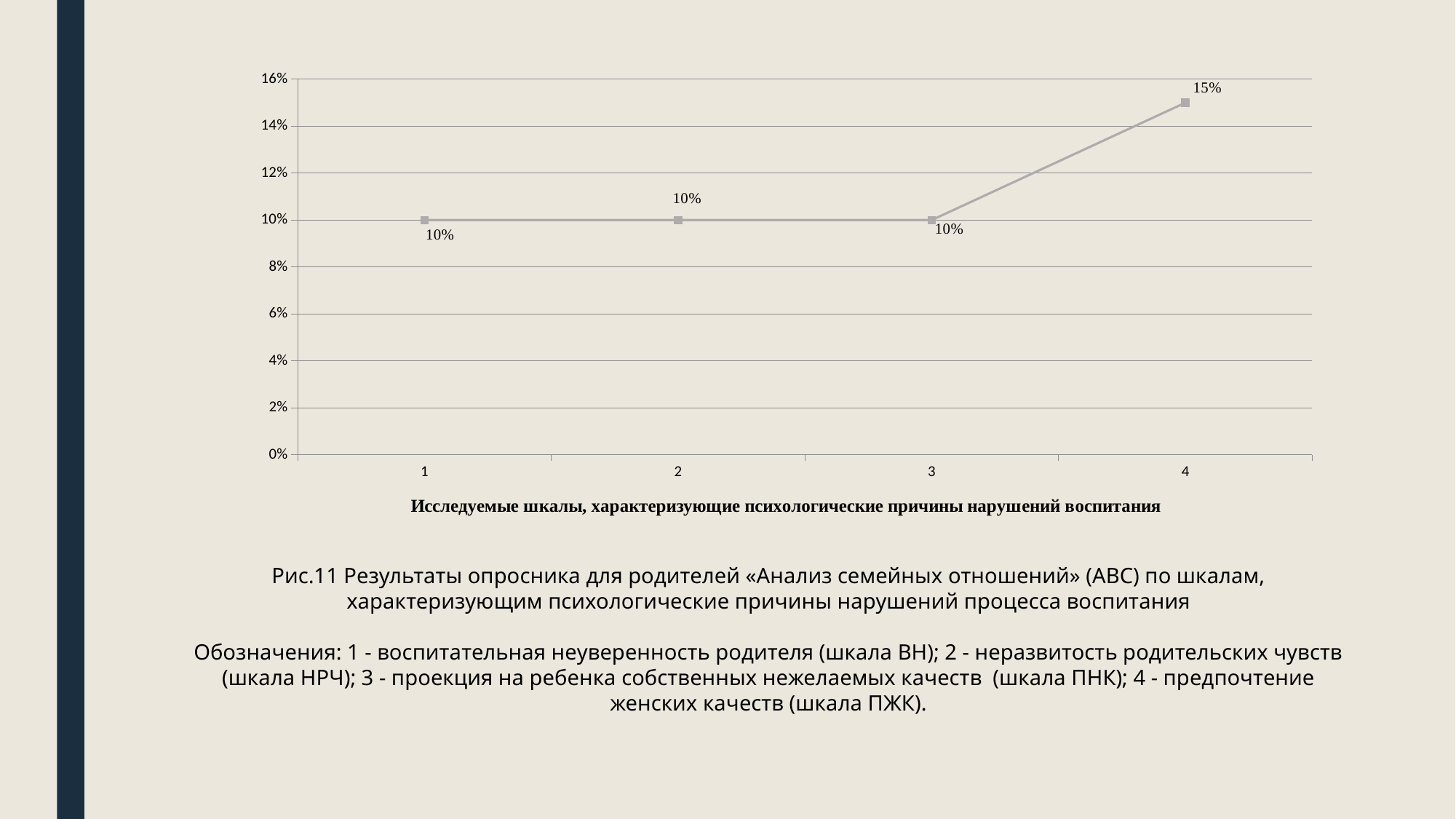
What is the x-axis title of the chart? Исследуемые шкалы, характеризующие психологические причины нарушений воспитания What is the difference between the values for category 4 and category 3? 5% What kind of chart is shown on the slide? line chart Which is larger, the value for category 4 or the value for category 1? category 4 Do the values rise or fall between category 3 and category 4? rise What is the value for category 1 on the chart? 10% Which category has the highest value on the chart? 4 What is the value for category 2 on the chart? 10% What is the value for category 4 on the chart? 15% Is the value for category 2 greater or less than 14%? less Is the value for category 4 greater or less than 12%? greater How many categories are plotted on the x axis of the chart? 4